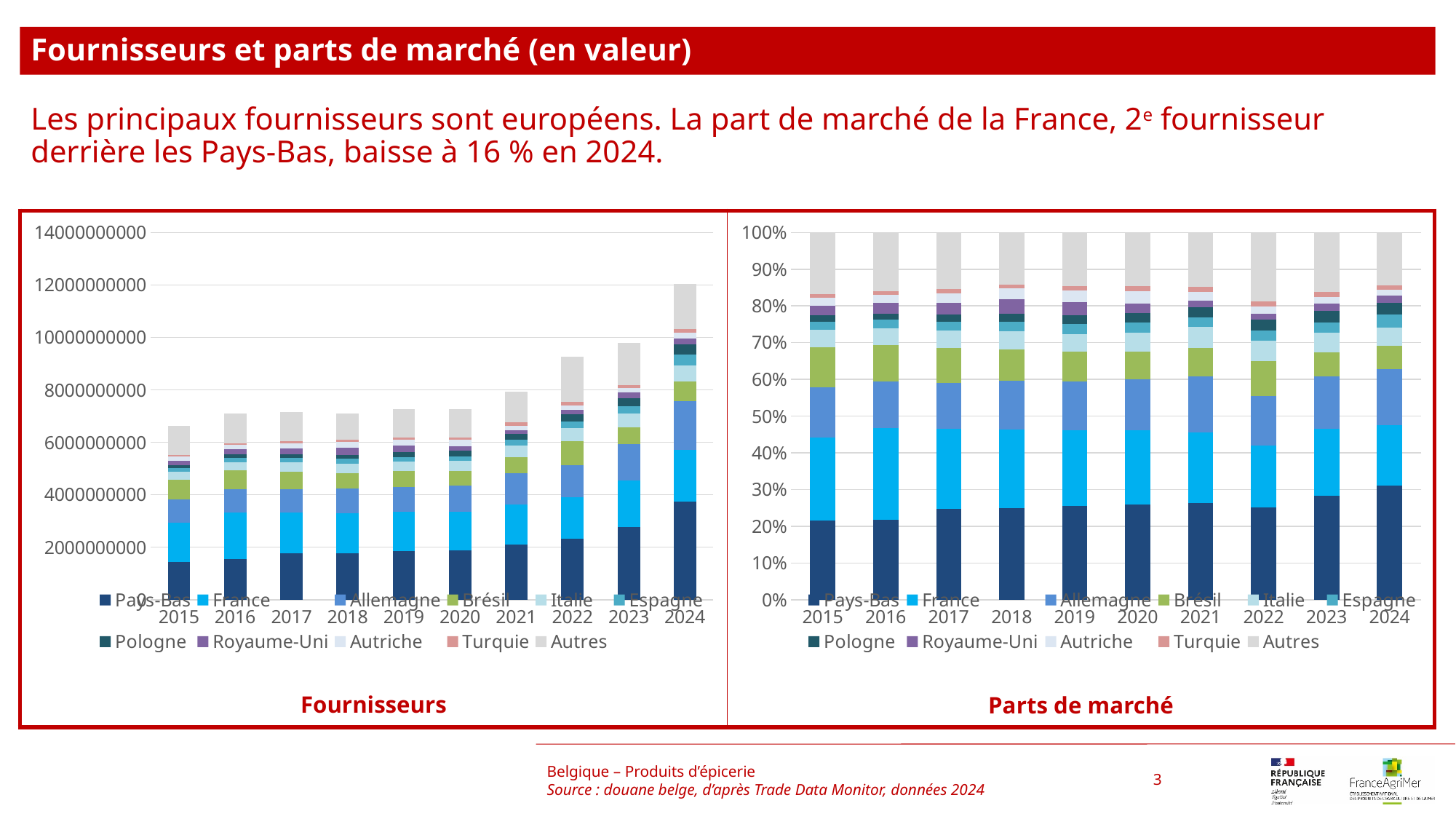
In the 'Fournisseurs' chart, which year has the highest total bar? 2024 In the 'Fournisseurs' chart, is the total bar for 2015 greater or less than 6000000000? greater How many years are shown on the x axis of the 'Fournisseurs' chart? 10 In the 'Fournisseurs' chart, do the total bars generally rise or fall from 2015 to 2024? rise In the 'Fournisseurs' chart, is the total bar for 2023 greater or less than 10000000000? less In the 'Fournisseurs' chart, which year has the lowest total bar? 2015 In the 'Parts de marché' chart, is the Pays-Bas share for 2024 greater or less than 20%? greater How many series does the legend of the 'Parts de marché' chart list? 11 In the 'Parts de marché' chart, which series is shown at the bottom of each stacked bar? Pays-Bas What kind of chart is the 'Fournisseurs' chart on the left? stacked bar chart